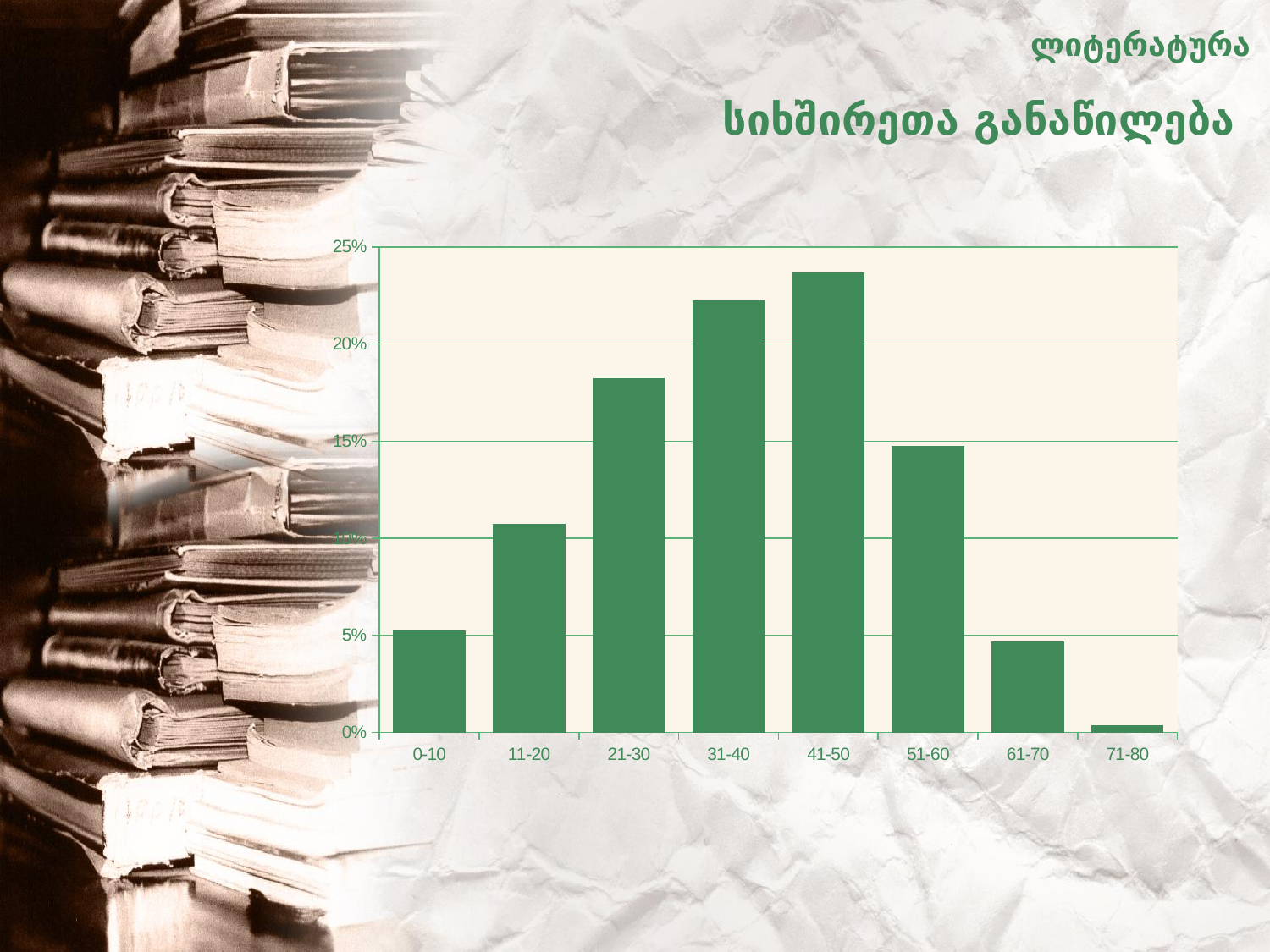
Which has the larger value, 21-30 or 51-60? 21-30 Is the value for 71-80 greater or less than 5%? less Which has the larger value, 11-20 or 61-70? 11-20 What kind of chart is shown on the slide? bar chart What is the highest value shown on the chart's y axis? 25% Do the values rise or fall along the x axis from 41-50 to 71-80? fall Is the value for 51-60 greater or less than 10%? greater Is the value for 21-30 greater or less than 20%? less Which category has the lowest value in the chart? 71-80 Which category has the highest value in the chart? 41-50 How many categories are shown on the x axis of the chart? 8